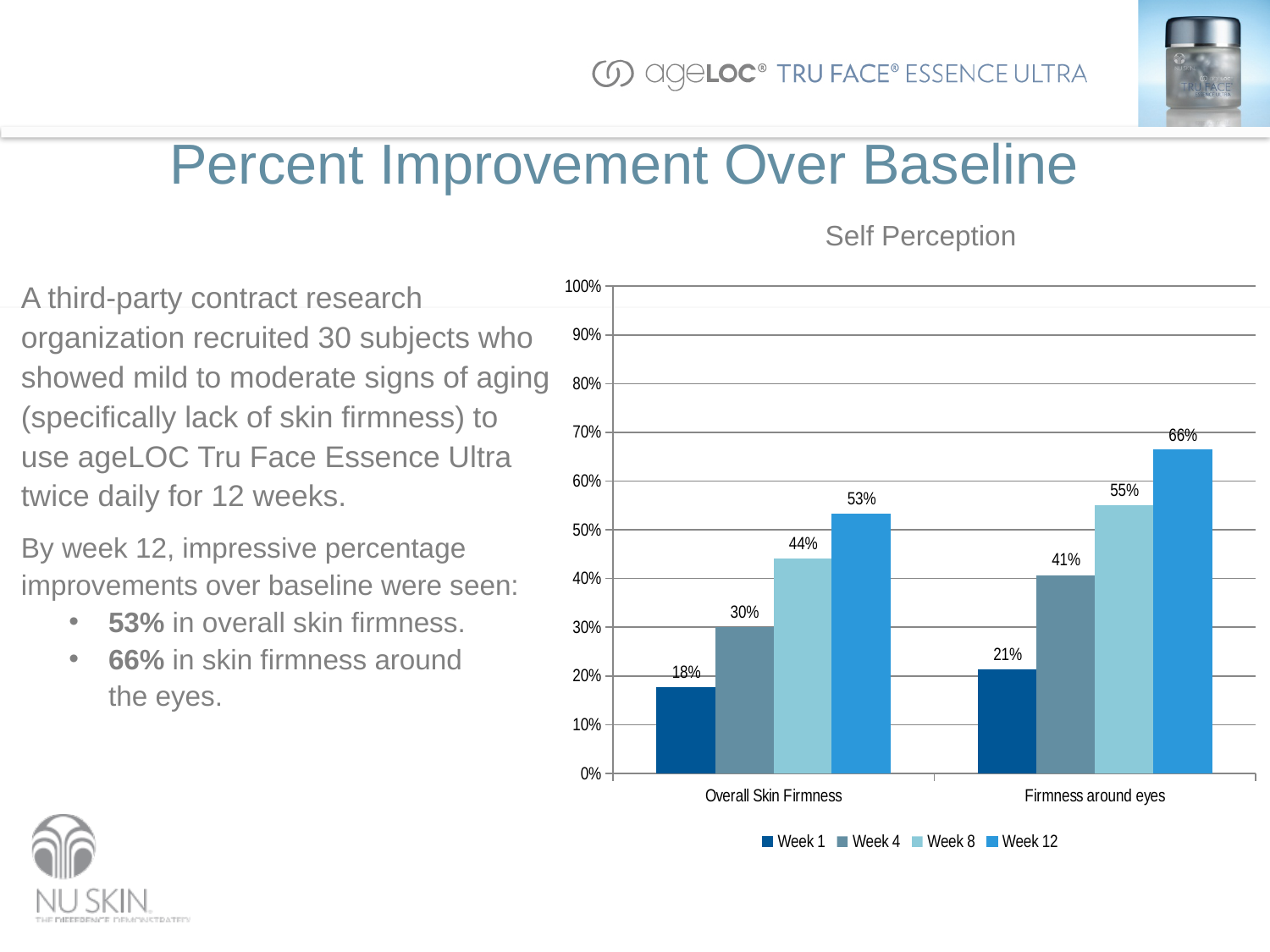
What is the Week 8 value for Overall Skin Firmness? 44% How many categories are shown on the x axis? 2 What is the difference between the Week 12 values for Firmness around eyes and Overall Skin Firmness? 13% What is the title of the chart? Self Perception What is the Week 1 value for Firmness around eyes? 21% Which is larger: the Week 8 value for Overall Skin Firmness or the Week 8 value for Firmness around eyes? Firmness around eyes How many series does the legend list? 4 Which series has the lowest value for Overall Skin Firmness? Week 1 What is the Week 4 value for Firmness around eyes? 41% Which series has the highest value for Firmness around eyes? Week 12 What kind of chart is shown on the slide? Bar chart What is the Week 12 value for Overall Skin Firmness? 53%